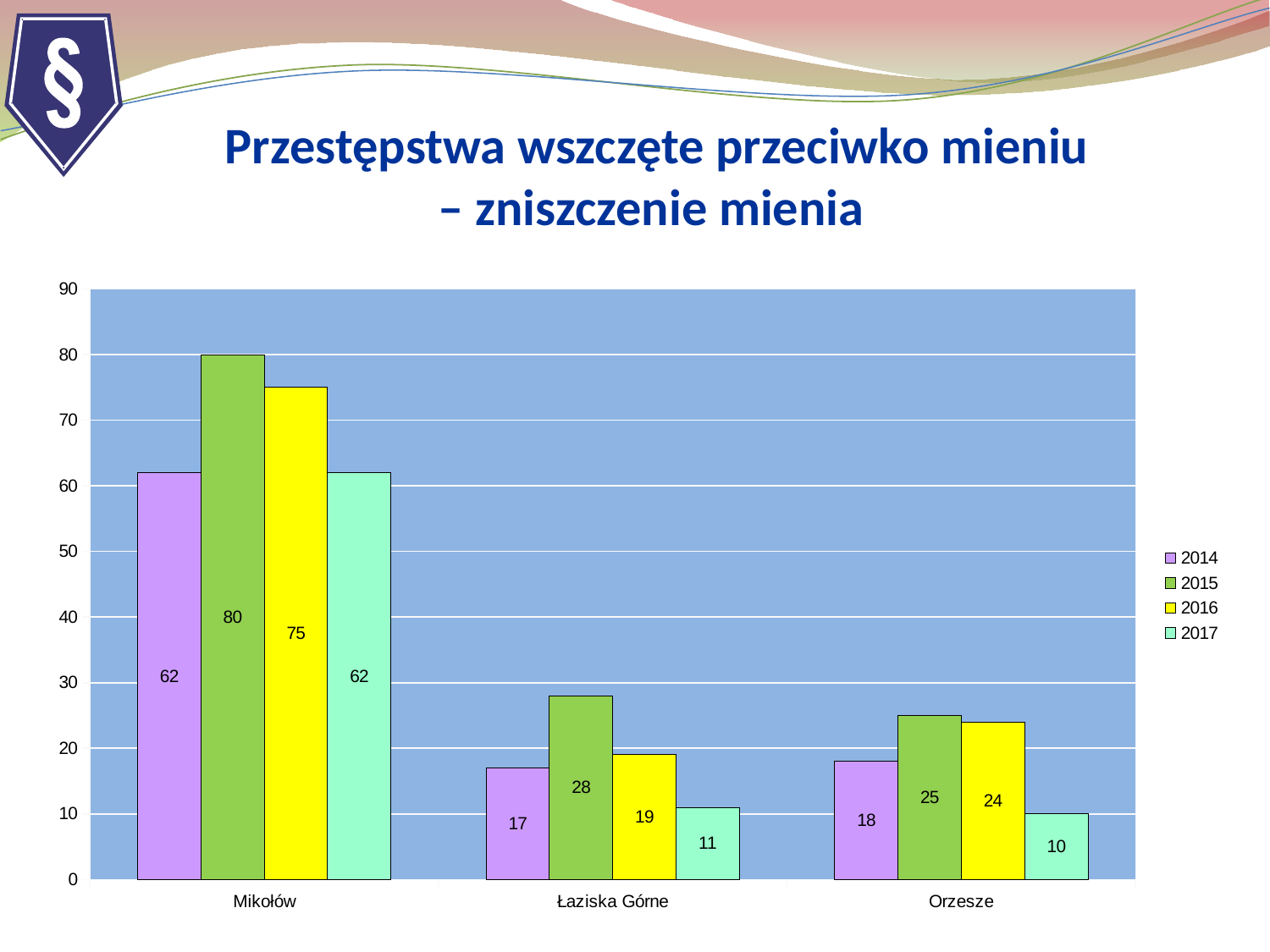
Is the value for Mikołów in 2016 greater or less than 70? greater What is the value for Orzesze in 2016? 24 What is the value for Łaziska Górne in 2017? 11 What kind of chart is shown on the slide? bar chart Which category has the lowest value in 2017? Orzesze Which category has the highest value in 2014? Mikołów What is the value for Mikołów in 2015? 80 Which colour represents the 2016 series in the legend? yellow How many categories are shown on the x axis? 3 What is the difference between the 2015 and 2017 values for Mikołów? 18 Which is larger for Łaziska Górne: the 2015 value or the 2016 value? 2015 How many series does the legend list? 4